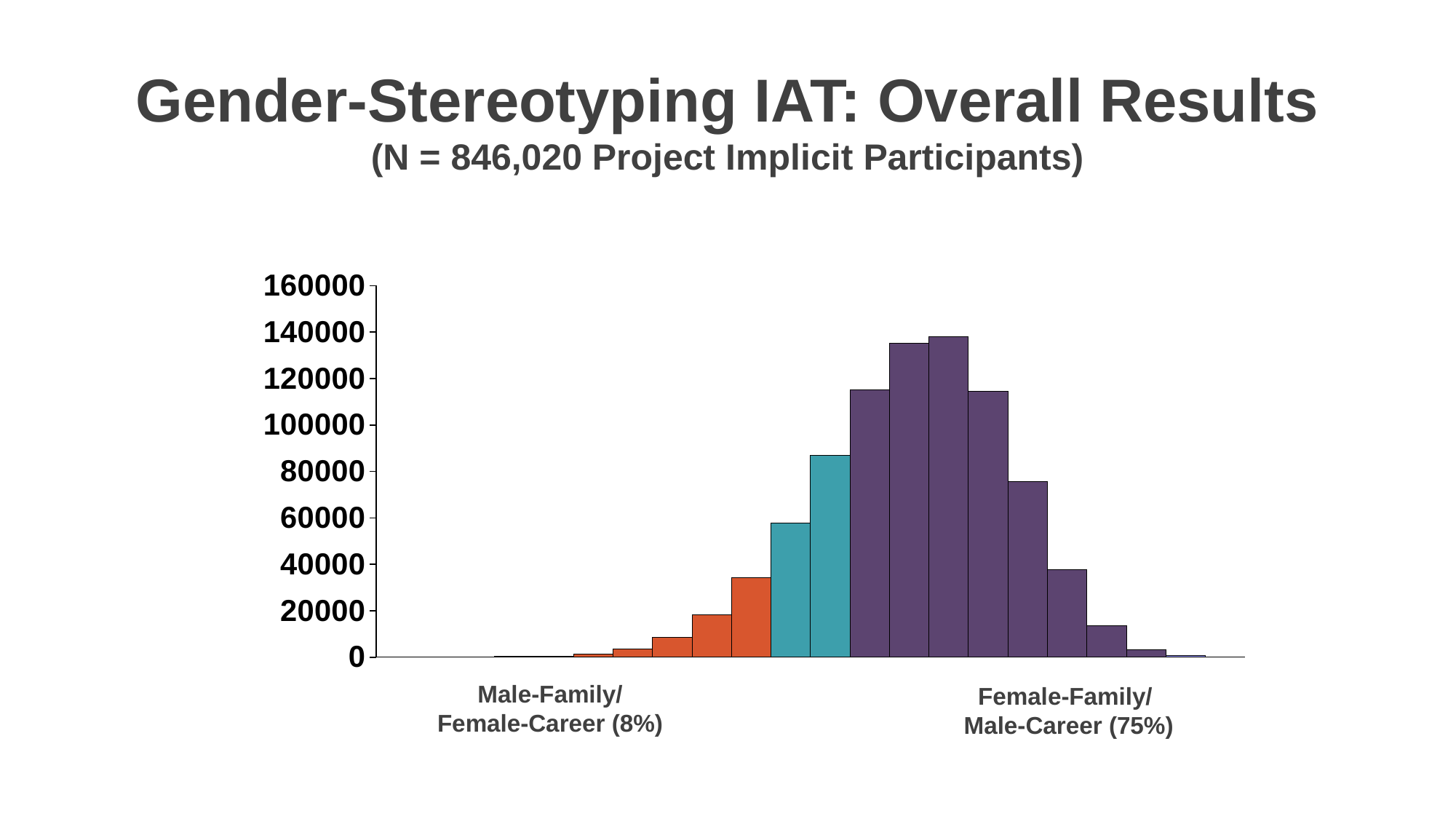
What is the title of the chart on the slide? Gender-Stereotyping IAT: Overall Results Which is larger, the tallest orange bar or the tallest teal bar? the tallest teal bar Which is larger, the tallest purple bar or the tallest teal bar? the tallest purple bar Is the value of the tallest orange bar greater or less than 40000? less What kind of chart is shown on the slide? bar chart What percentage is shown for the Female-Family/Male-Career side of the distribution? 75% What is the highest value shown on the vertical axis? 160000 What percentage is shown for the Male-Family/Female-Career side of the distribution? 8% Do the bar heights rise or fall moving from the tallest bar toward the right end of the x axis? fall Is the value of the tallest teal bar greater or less than 80000? greater How many Project Implicit participants does the subtitle say were included? 846,020 Is the value of the tallest bar greater or less than 120000? greater